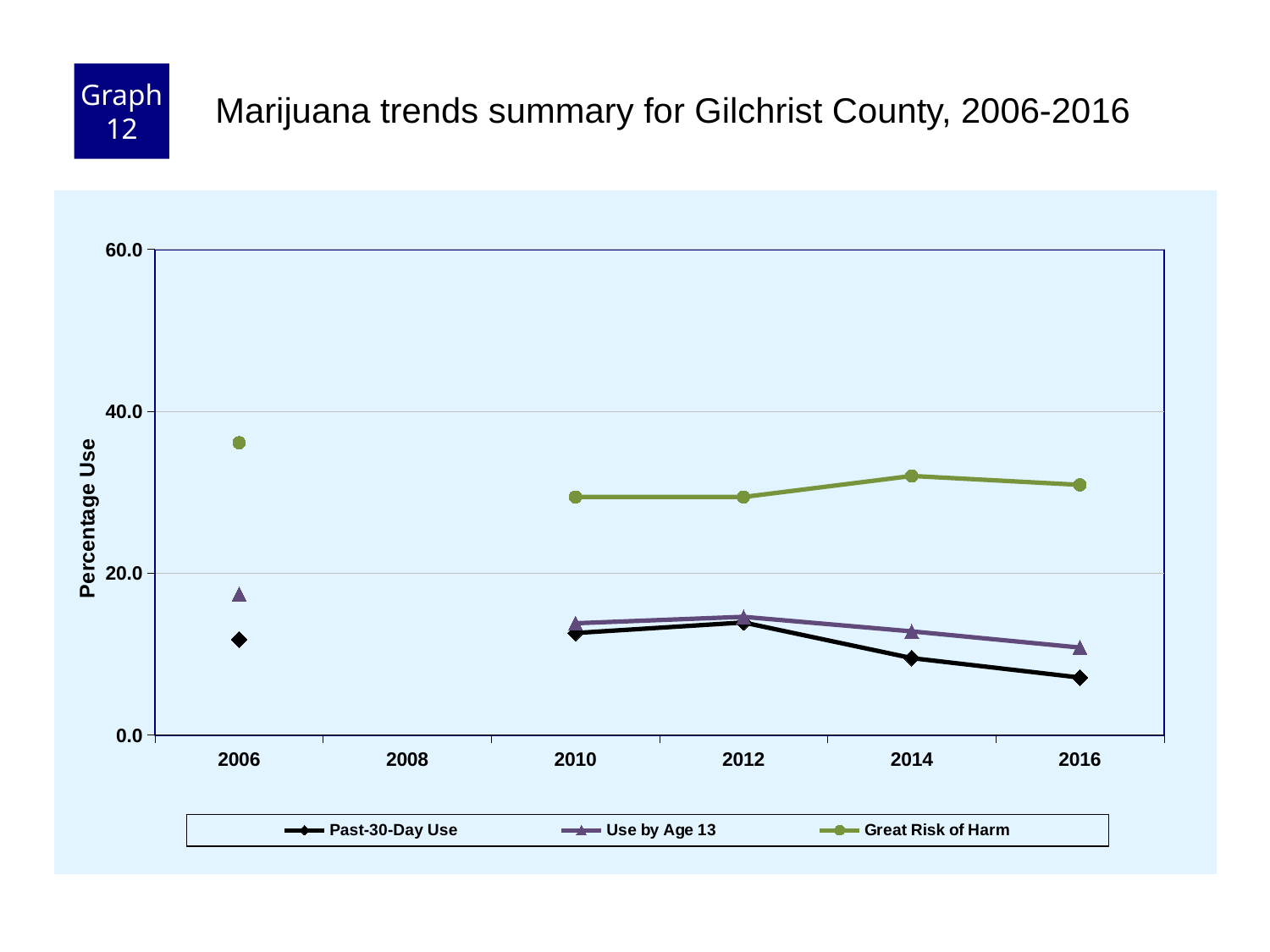
How many years are labeled on the x axis? 6 What kind of chart is shown on the slide? Line chart Which series has the highest value in 2016? Great Risk of Harm Is the value for Great Risk of Harm in 2014 greater or less than 20.0? greater Is the value for Past-30-Day Use in 2016 greater or less than 20.0? less What is the label on the vertical axis? Percentage Use In which year is the Past-30-Day Use value lowest? 2016 Which is larger for Past-30-Day Use: the value in 2012 or the value in 2016? 2012 How many series does the legend list? 3 What is the title of the chart? Marijuana trends summary for Gilchrist County, 2006-2016 Is the value for Great Risk of Harm in 2010 greater or less than 40.0? less In which year is the Great Risk of Harm value highest? 2006